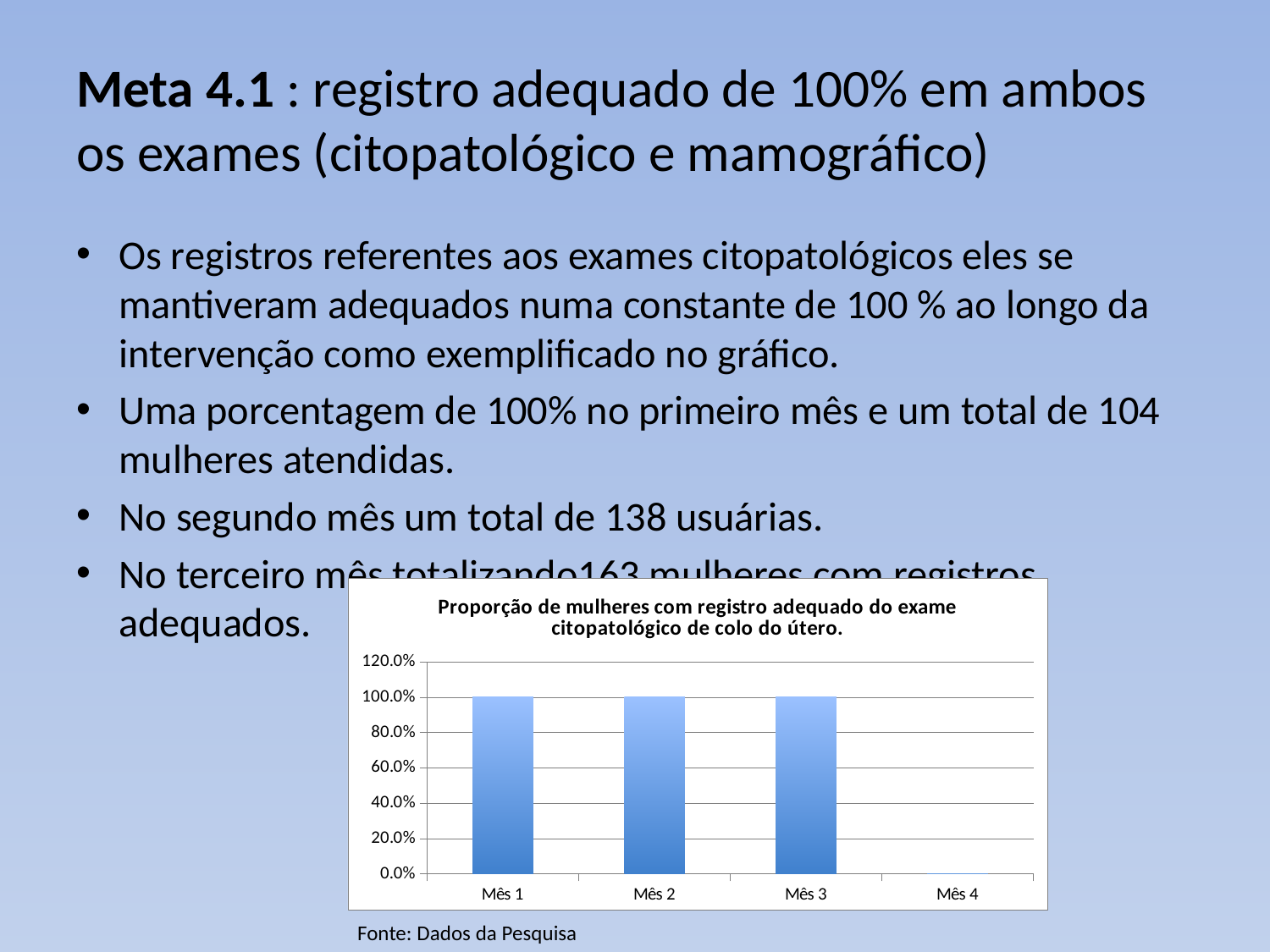
What is the difference between the value for Mês 1 and the value for Mês 4? 100.0% How many months (categories) are shown on the x axis of the chart? 4 Which month has the lowest value in the chart? Mês 4 What is the value for Mês 1 in the chart? 100.0% What is the value for Mês 4 in the chart? 0.0% What is the value for Mês 3 in the chart? 100.0% Which is larger, the value for Mês 3 or the value for Mês 4? Mês 3 Is the value for Mês 4 greater or less than 20.0%? less What is the highest tick value shown on the y axis of the chart? 120.0% What kind of chart is shown on the slide? Bar chart What is the title of the chart? Proporção de mulheres com registro adequado do exame citopatológico de colo do útero. Is the value for Mês 2 greater or less than 80.0%? greater